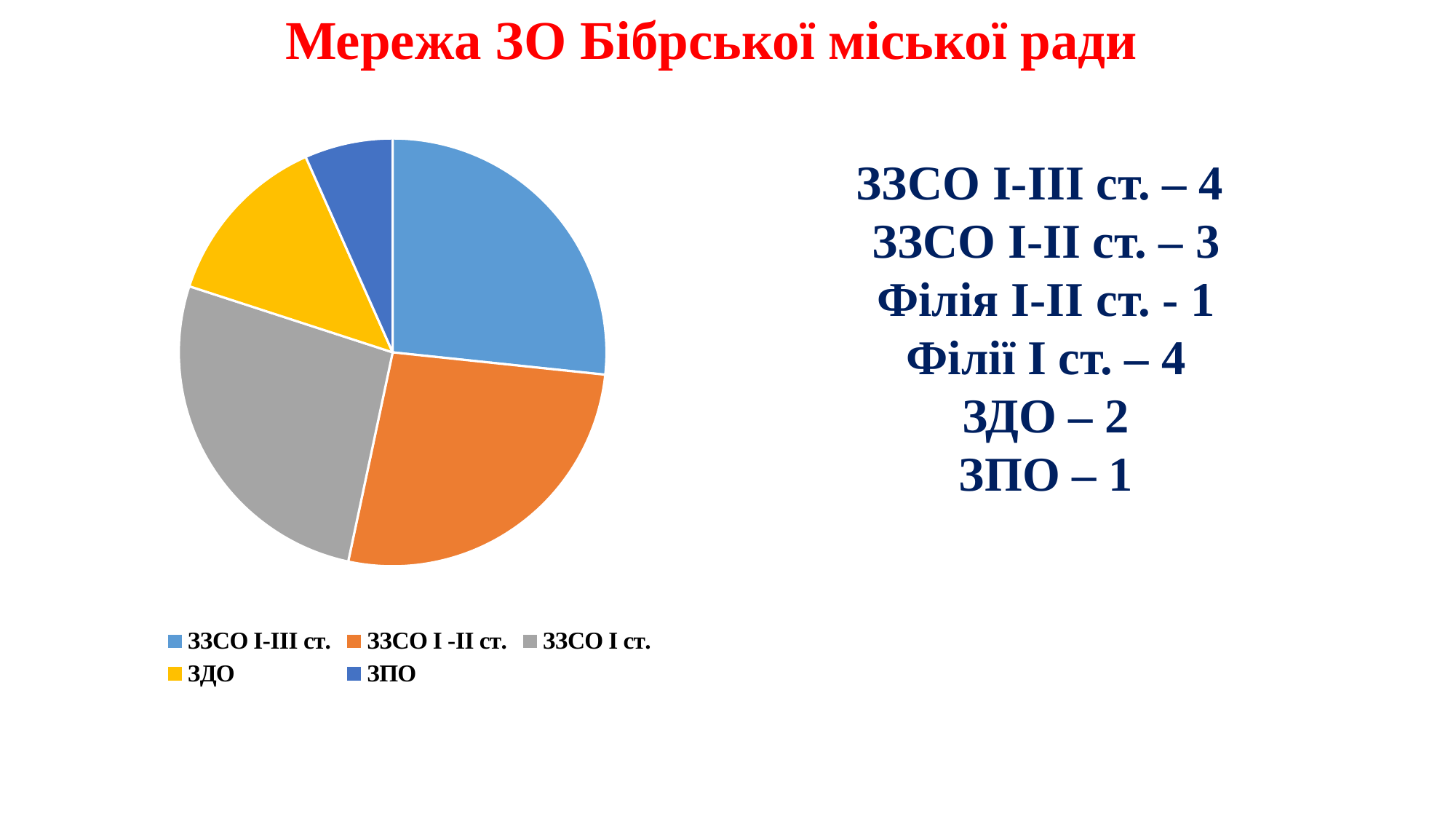
What colour is the ЗДО slice in the pie chart? yellow Which slice is larger in the pie chart, ЗЗСО І-ІІІ ст. or ЗДО? ЗЗСО І-ІІІ ст. How many slices does the pie chart have? 5 How many entries does the legend of the pie chart list? 5 Which slice is larger in the pie chart, ЗДО or ЗПО? ЗДО Which slice is larger in the pie chart, ЗЗСО І ст. or ЗПО? ЗЗСО І ст. What is the title of the slide containing the pie chart? Мережа ЗО Бібрської міської ради Which category has the smallest slice in the pie chart? ЗПО What kind of chart is shown on the slide? pie chart